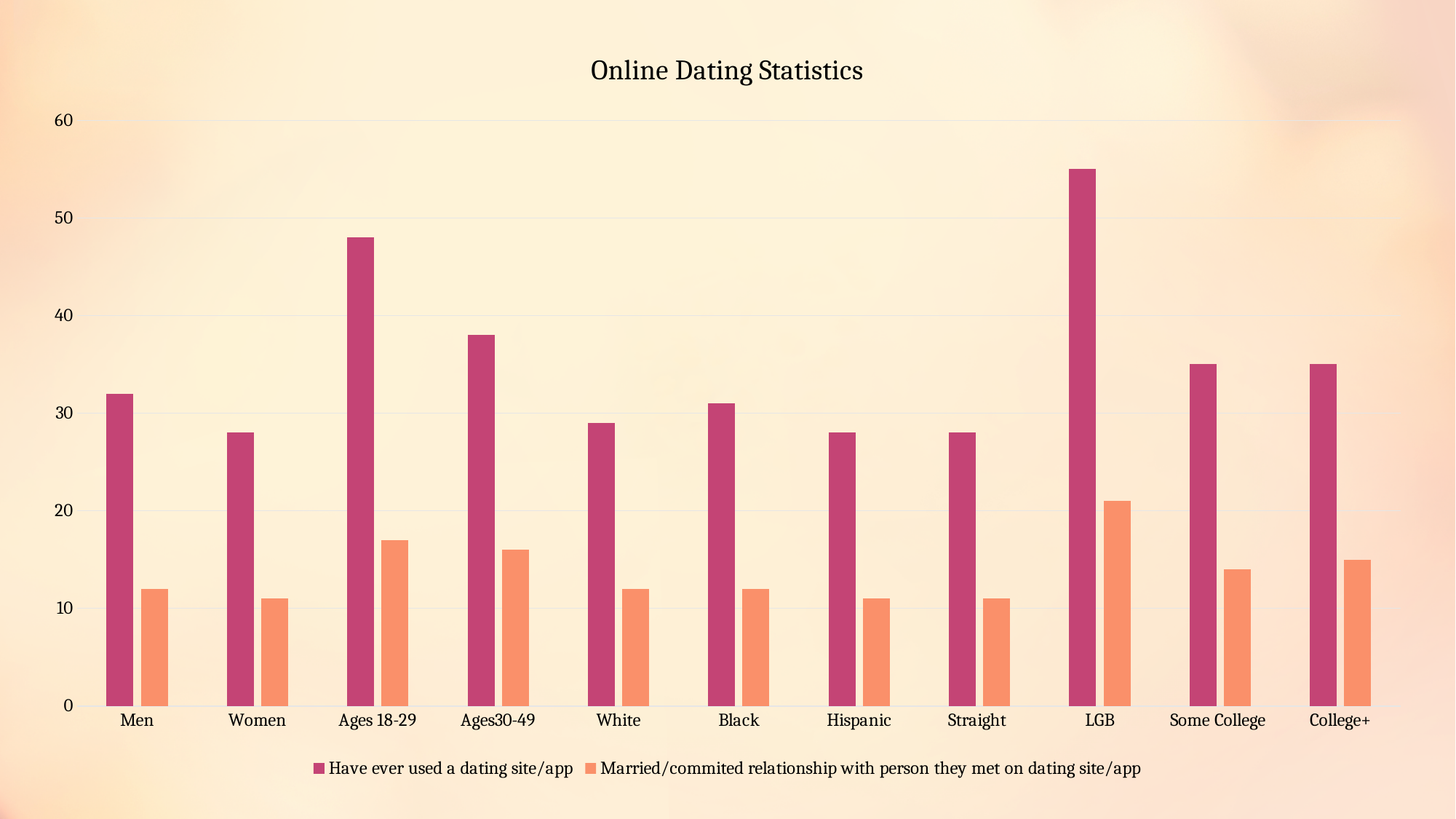
For 'Have ever used a dating site/app', which is larger: LGB or Straight? LGB How many categories are shown on the x axis? 11 Is the 'Married/commited relationship with person they met on dating site/app' value for Ages 18-29 greater or less than 20? less Which category has the highest value for 'Married/commited relationship with person they met on dating site/app'? LGB What is the title of the chart? Online Dating Statistics How many series does the legend list? 2 Is the 'Have ever used a dating site/app' value for Ages 18-29 greater or less than 40? greater Is the 'Have ever used a dating site/app' value for LGB greater or less than 50? greater What kind of chart is shown on the slide? bar chart Which category has the highest value for 'Have ever used a dating site/app'? LGB For 'Have ever used a dating site/app', which is larger: Ages 18-29 or Ages30-49? Ages 18-29